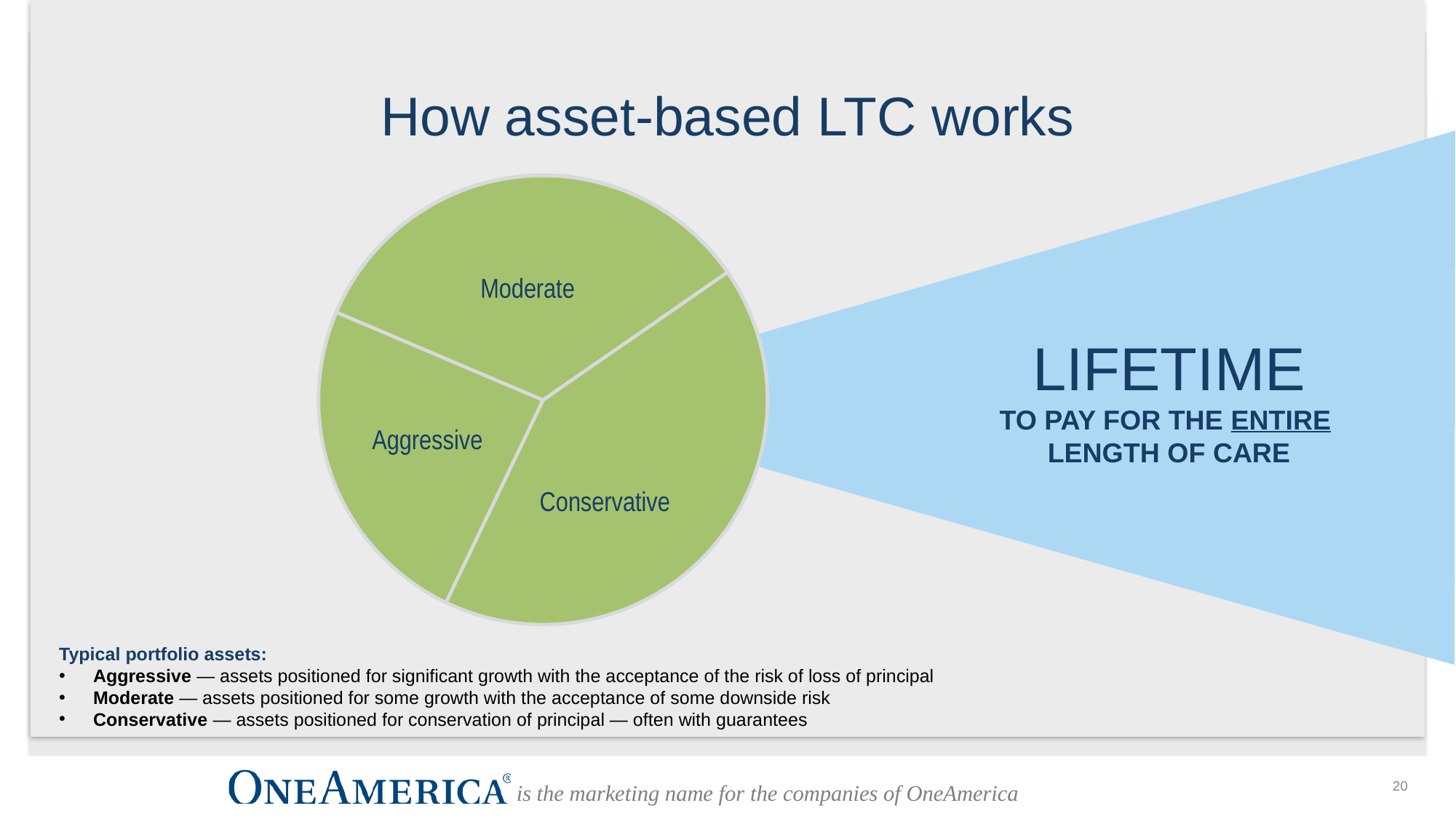
What are the labels of the three slices in the pie chart? Moderate, Aggressive, Conservative Which slice is larger, Aggressive or Conservative? Conservative How many slices does the pie chart have? 3 What kind of chart is shown on the slide? Pie chart What colour are the slices of the pie chart? Green Which slice of the pie chart is the smallest? Aggressive Which slice of the pie chart is positioned at the top? Moderate Which slice is larger, Aggressive or Moderate? Moderate